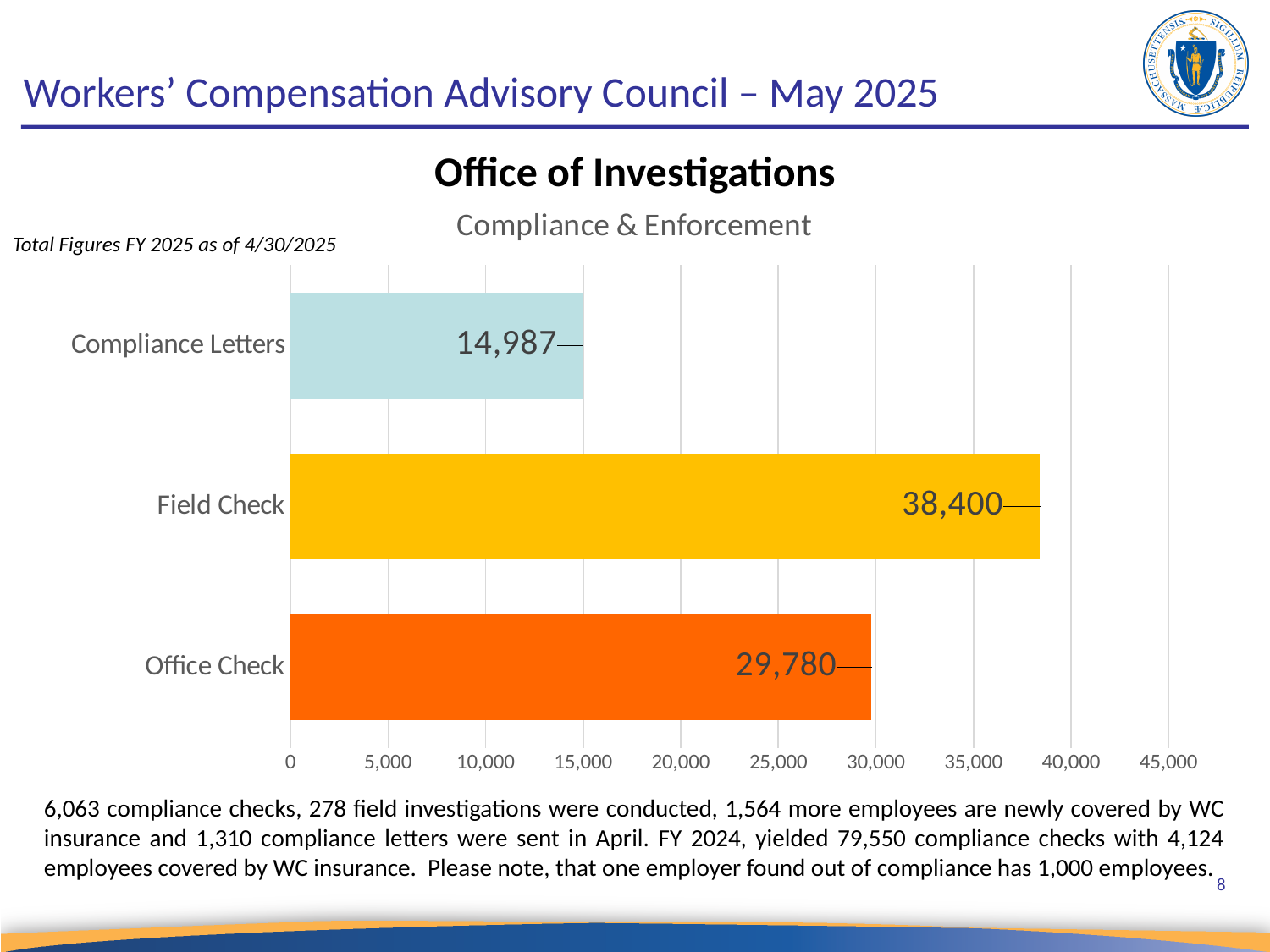
Which category has the highest value? Field Check What kind of chart is shown on the slide? Bar chart What is the value for Field Check? 38,400 How many categories are shown in the chart? 3 Which category has the lowest value? Compliance Letters What is the title of the chart? Compliance & Enforcement What is the value for Office Check? 29,780 What is the difference between the Office Check and Compliance Letters values? 14,793 Which is larger, Office Check or Compliance Letters? Office Check What is the value for Compliance Letters? 14,987 What is the difference between the Field Check and Office Check values? 8,620 Is the value for Field Check greater or less than 35,000? greater